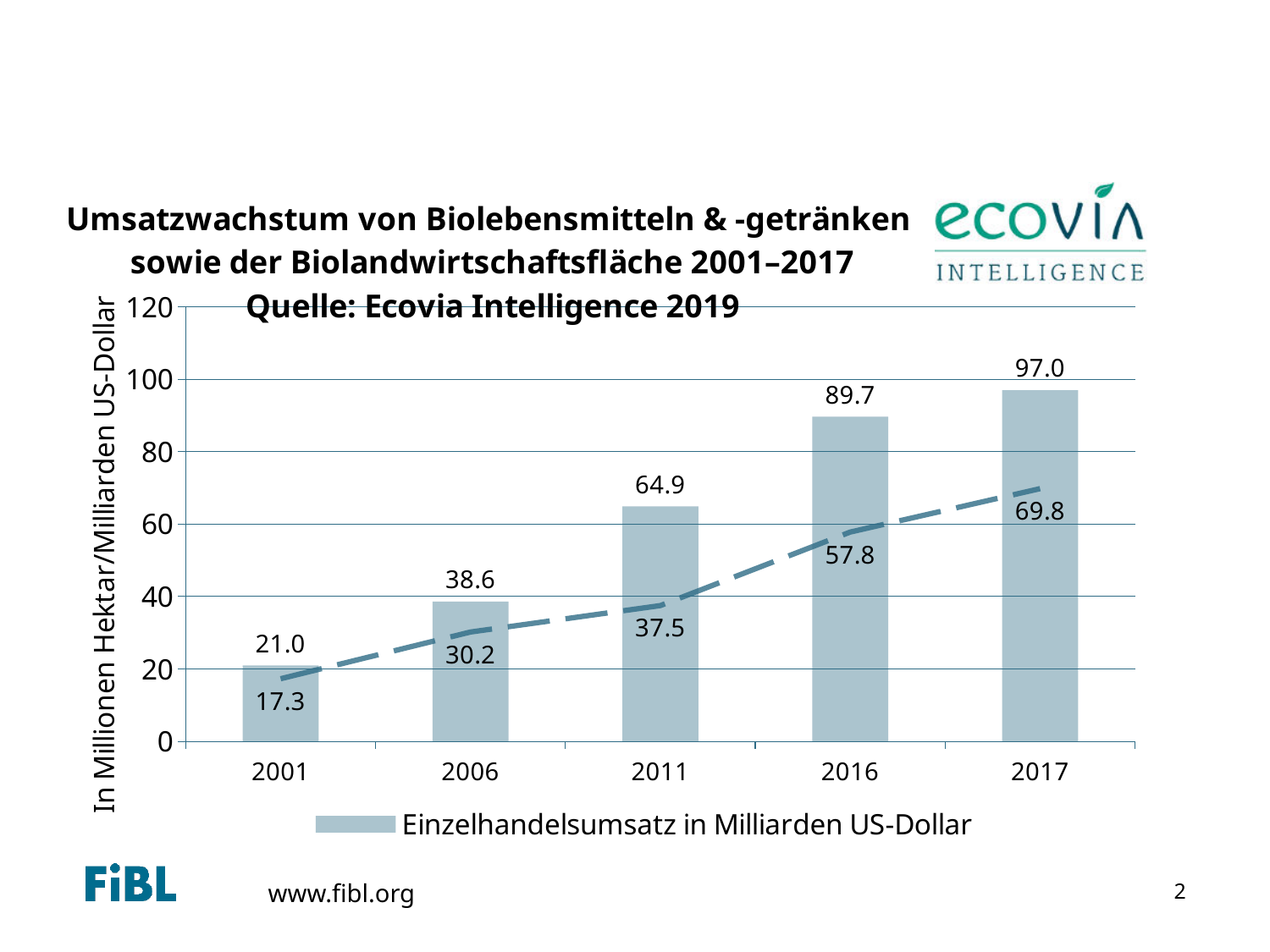
Which year has the highest bar value? 2017 What value does the dashed line show for 2017? 69.8 What is the value of the bar for 2001? 21.0 Which is larger, the bar value for 2006 or the dashed line value for 2006? The bar value (38.6) Is the bar value for 2016 greater or less than 80? greater Do the bar values rise or fall from 2001 to 2017? rise What value does the dashed line show for 2006? 30.2 What is the retail sales value (Einzelhandelsumsatz) shown for 2011? 64.9 How many series does the legend list? 1 What is the difference between the bar values for 2017 and 2016? 7.3 How many years are shown on the x axis? 5 Which year has the lowest bar value? 2001